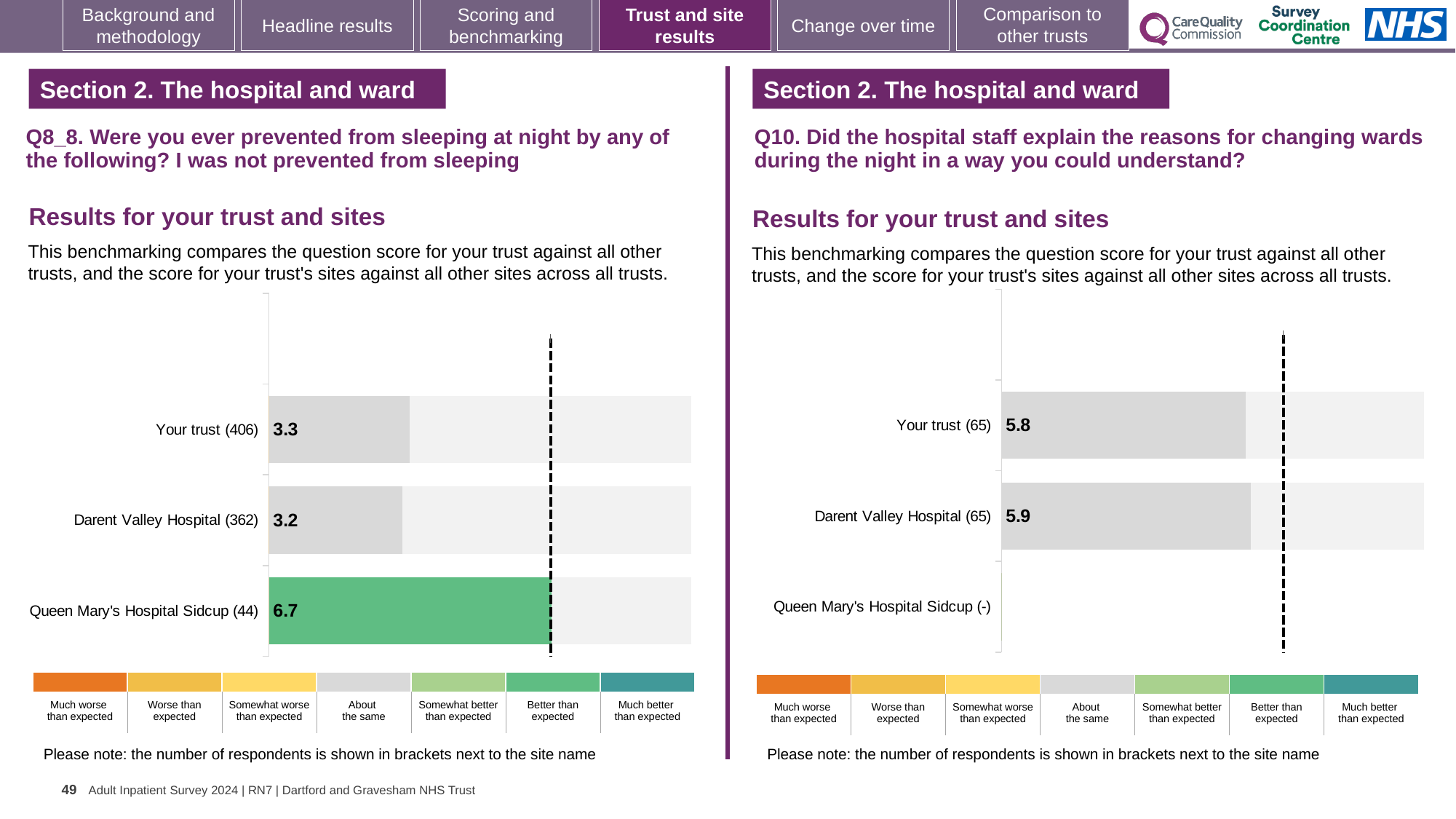
On the right chart (Q10), how many respondents are shown for Your trust? 65 On the left chart (Q8_8), how many respondents are shown for Queen Mary's Hospital Sidcup? 44 On the left chart (Q8_8), what is the score for Queen Mary's Hospital Sidcup? 6.7 On the left chart (Q8_8), what is the score for Darent Valley Hospital? 3.2 On the left chart (Q8_8), what is the score for Your trust? 3.3 On the right chart (Q10), what is the difference between the scores for Darent Valley Hospital and Your trust? 0.1 On the left chart (Q8_8), what is the difference between the scores for Queen Mary's Hospital Sidcup and Darent Valley Hospital? 3.5 On the right chart (Q10), what is the score for Your trust? 5.8 On the right chart (Q10), what is the score for Darent Valley Hospital? 5.9 How many rows (trust and sites) are listed on the left chart (Q8_8)? 3 What kind of chart is used on the left (Q8_8)? Bar chart On the left chart (Q8_8), which site or trust has the highest score? Queen Mary's Hospital Sidcup